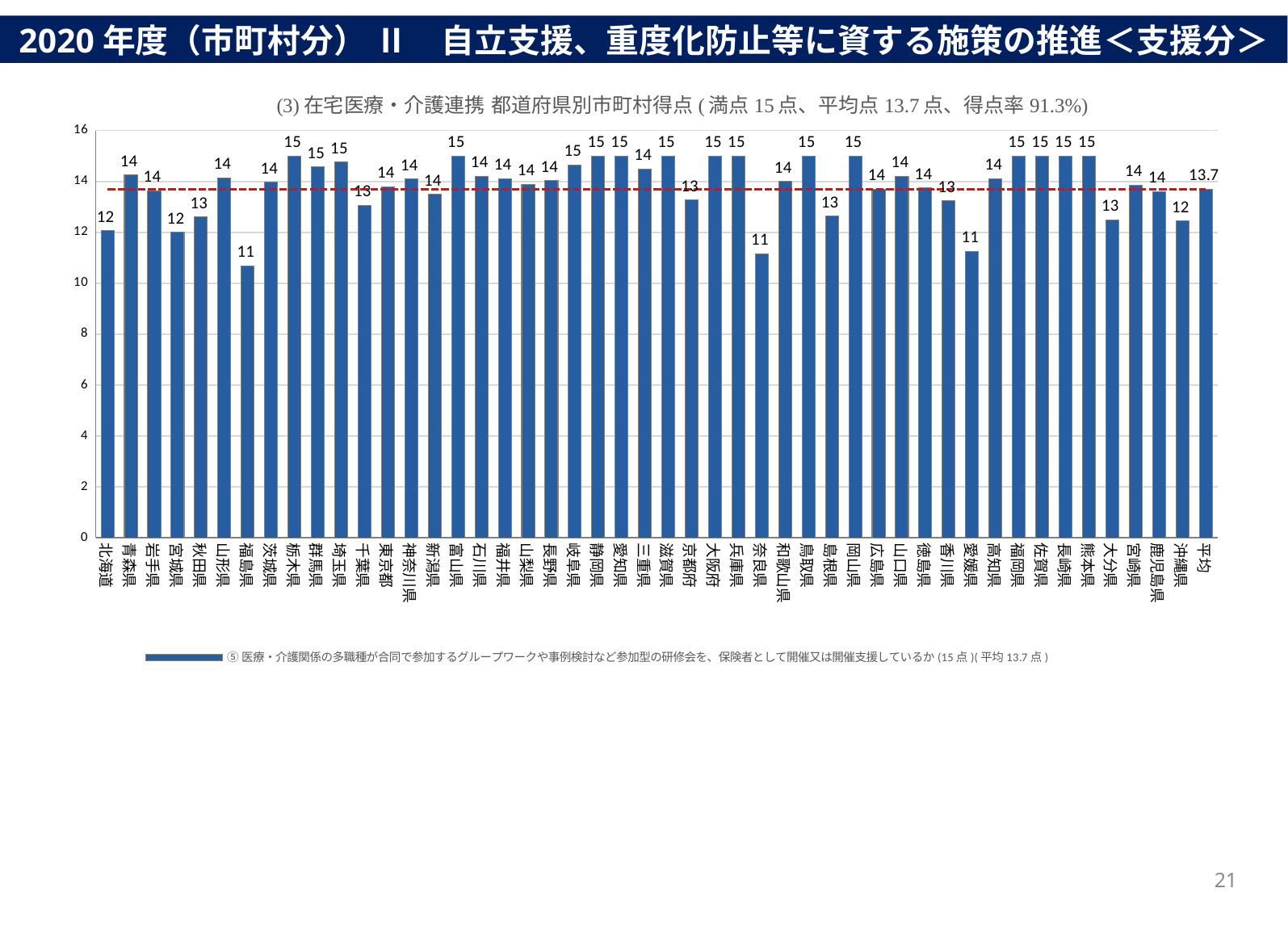
Which has the larger value, 奈良県 or 和歌山県? 和歌山県 How many bars are plotted in the chart, including the 平均 bar? 48 What value does the red dashed horizontal line across the chart represent? 13.7 (平均点) What is the value shown for 平均 (the last bar)? 13.7 What is the maximum possible score (満点) stated in the chart title? 15点 Is the value for 愛媛県 greater or less than 12? less What kind of chart is shown on the slide? bar chart What is the lowest value labelled on any bar in the chart? 11 What is the value for 福島県? 11 What is the value for 栃木県? 15 What is the difference between the values for 栃木県 and 北海道? 3 What is the value for 北海道? 12